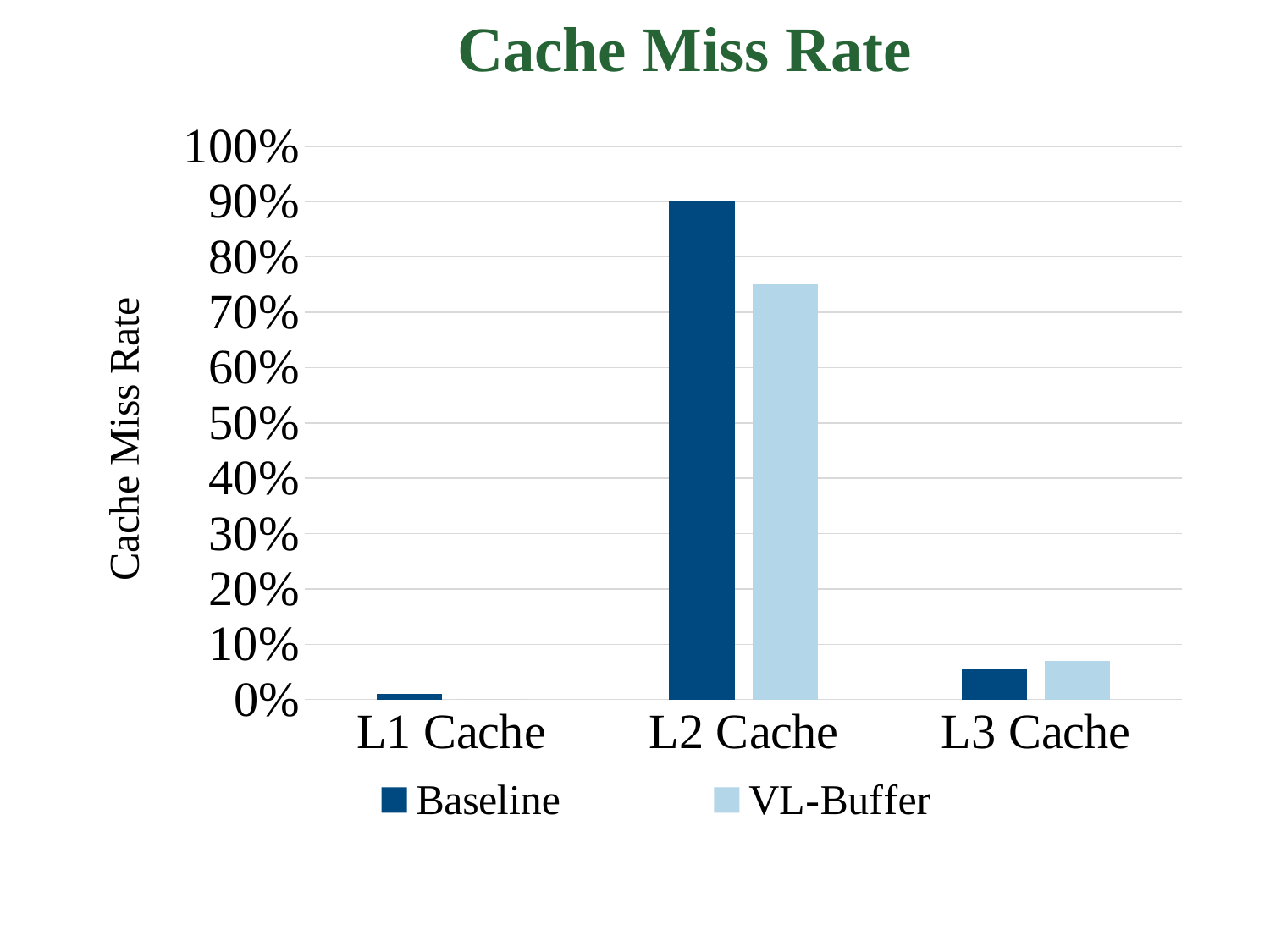
How many series does the legend list? 2 What is the Baseline cache miss rate for L2 Cache? 90% Is the Baseline miss rate for L3 Cache greater or less than 10%? less Which series is shown in the darker blue colour? Baseline Is the VL-Buffer miss rate for L2 Cache greater or less than 80%? less Is the VL-Buffer miss rate for L2 Cache greater or less than 70%? greater For L2 Cache, which is larger, the Baseline or the VL-Buffer miss rate? Baseline Which cache level has the lowest Baseline miss rate? L1 Cache Which cache level has the highest Baseline miss rate? L2 Cache What kind of chart is shown on the slide? bar chart What is the title of the chart? Cache Miss Rate How many cache categories are shown on the x axis? 3